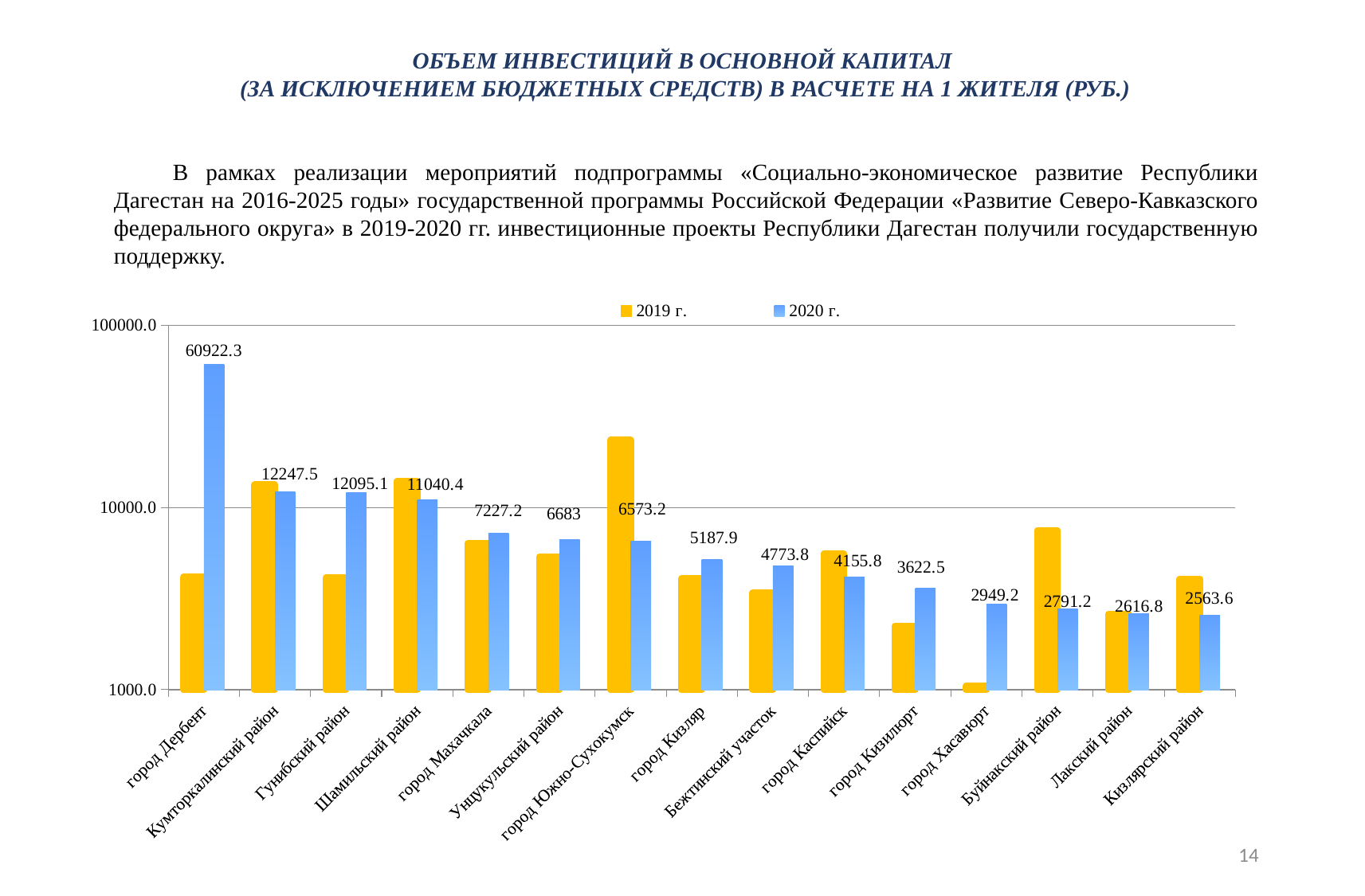
What kind of chart is shown on the slide? bar chart How many categories are shown on the x axis? 15 What is the 2020 г. value for Буйнакский район? 2791.2 Is the 2019 г. value for город Дербент greater or less than 10000? less Which category has the highest 2020 г. value? город Дербент Is the 2019 г. value for город Южно-Сухокумск greater or less than 10000? greater What is the 2020 г. value for город Махачкала? 7227.2 Which is larger: the 2020 г. value for город Кизляр or for Бежтинский участок? город Кизляр How many series does the legend list? 2 Which category has the lowest 2020 г. value? Кизлярский район What is the 2020 г. value for город Дербент? 60922.3 What is the difference between the 2020 г. values for Кумторкалинский район and Гунибский район? 152.4